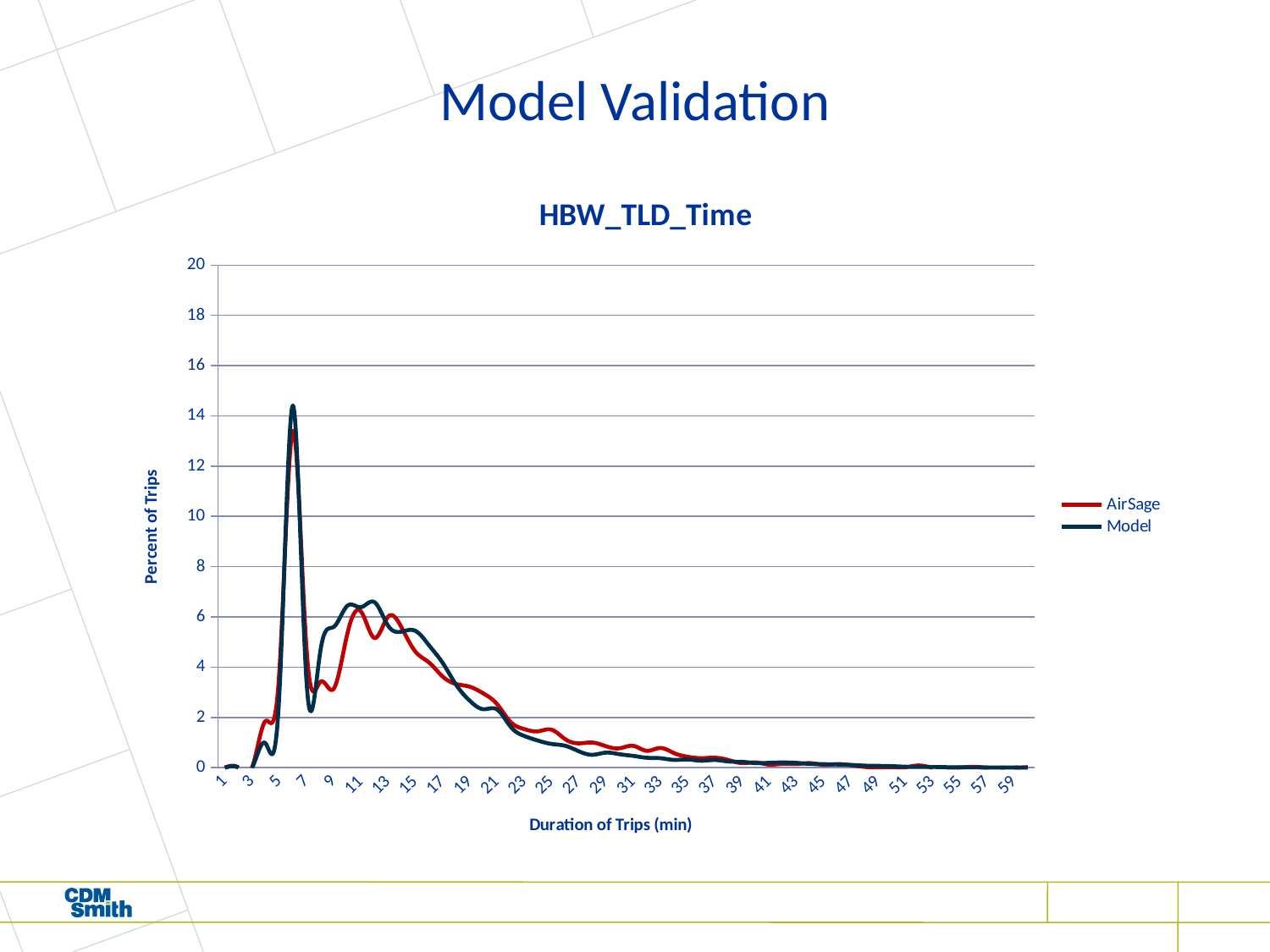
Which series reaches the higher peak, AirSage or Model? Model Is the value for Model at 59 min greater or less than 2? less Is the value for AirSage at 25 min greater or less than 2? less How many series does the legend list? 2 What kind of chart is shown on the slide? line chart After the peak near 6 min, do the values rise or fall as trip duration increases toward 59 min? fall Is the peak value of the AirSage series greater or less than 12? greater What is the label of the y axis? Percent of Trips What is the title of the chart? HBW_TLD_Time How many tick labels are shown on the x axis? 30